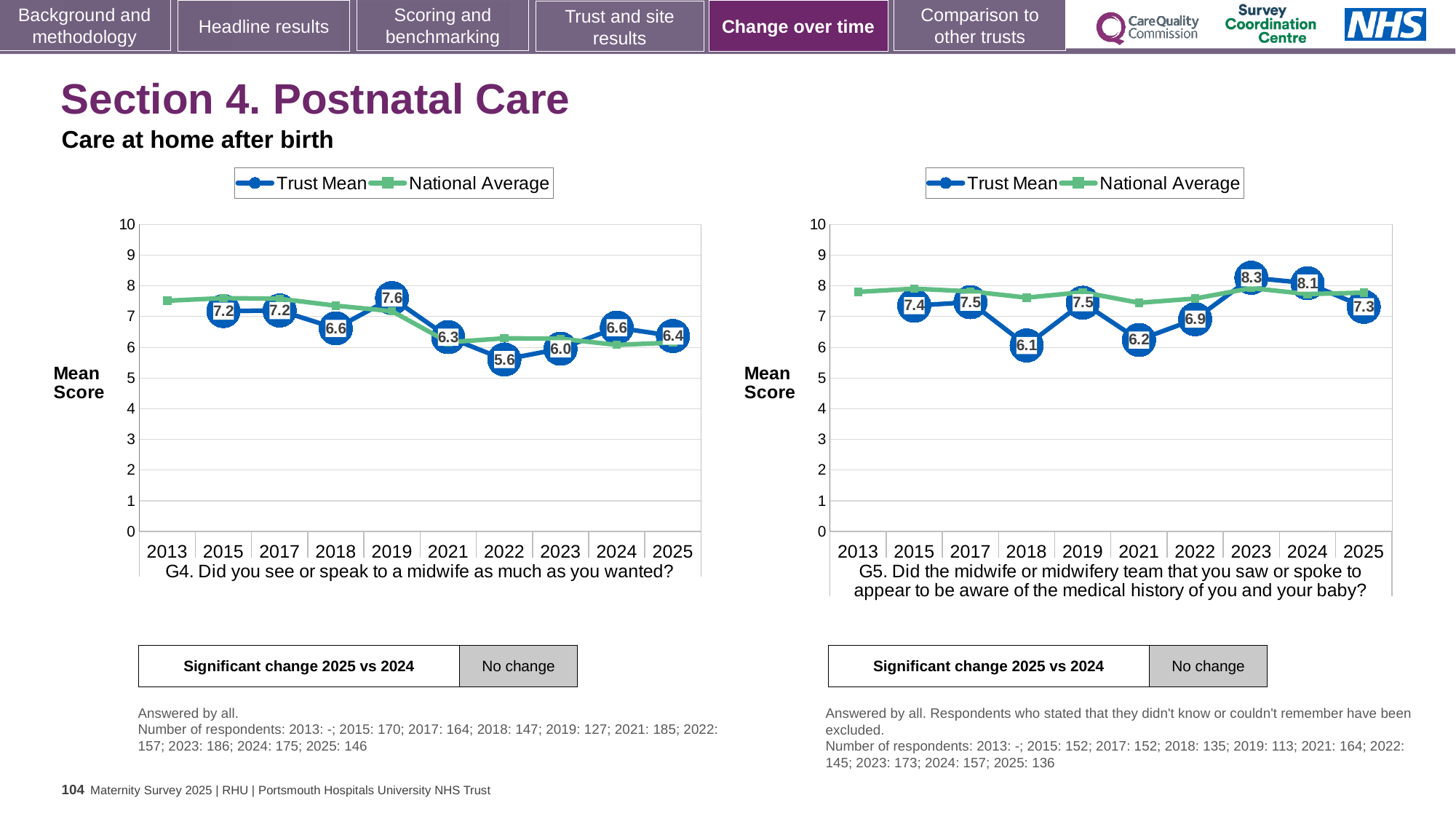
How many series does the legend of the G4 chart (left) list? 2 In the G5 chart (right), which year has the highest Trust Mean score? 2023 In the G4 chart (left), which year has the lowest Trust Mean score? 2022 In the G5 chart (right), what is the difference between the Trust Mean scores for 2024 and 2025? 0.8 In the G5 chart (right), what is the Trust Mean score for 2023? 8.3 In the G5 chart (right), is the National Average for 2013 greater or less than 7? greater In the G4 chart (left), is the Trust Mean score for 2024 greater or less than the score for 2025? greater In the G4 chart (left), what is the difference between the Trust Mean scores for 2019 and 2022? 2.0 In the G5 chart (right), which year has the lowest Trust Mean score? 2018 In the G4 chart (left), what is the Trust Mean score for 2022? 5.6 What type of chart is the G5 chart (right)? Line chart In the G4 chart (left), what is the Trust Mean score for 2019? 7.6